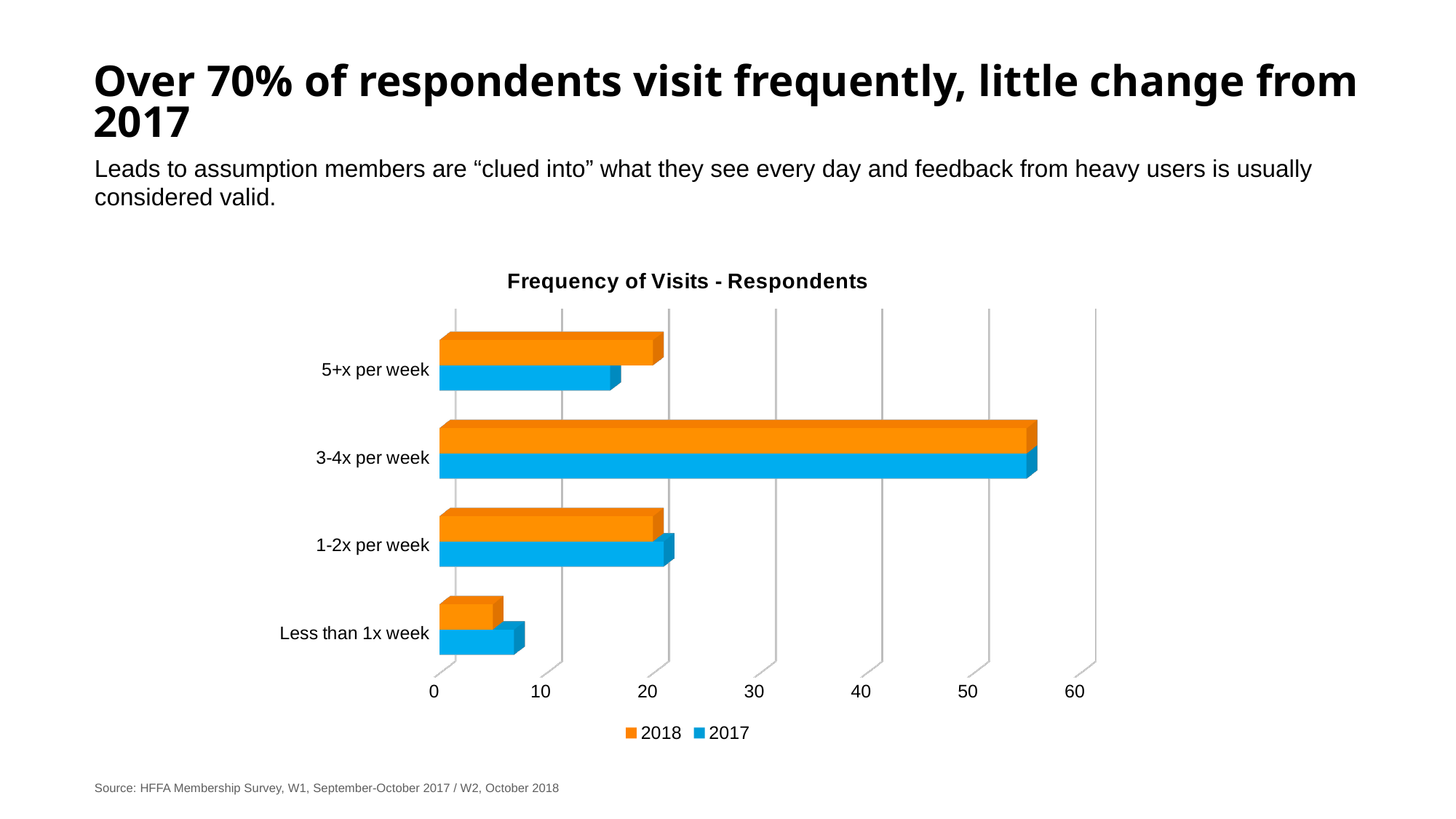
For 5+x per week, which series has the larger value, 2018 or 2017? 2018 What kind of chart is shown on the slide? bar chart For Less than 1x week, which series has the larger value, 2018 or 2017? 2017 How many visit-frequency categories are shown on the chart? 4 Which colour represents the 2017 series in the legend? blue Which category has the lowest value for 2017? Less than 1x week How many series does the legend list? 2 Is the 2018 value for 3-4x per week greater or less than 50? greater Is the 2017 value for 5+x per week greater or less than 20? less Which category has the highest value for 2018? 3-4x per week What is the title of the chart? Frequency of Visits - Respondents Is the 2018 value for Less than 1x week greater or less than 10? less